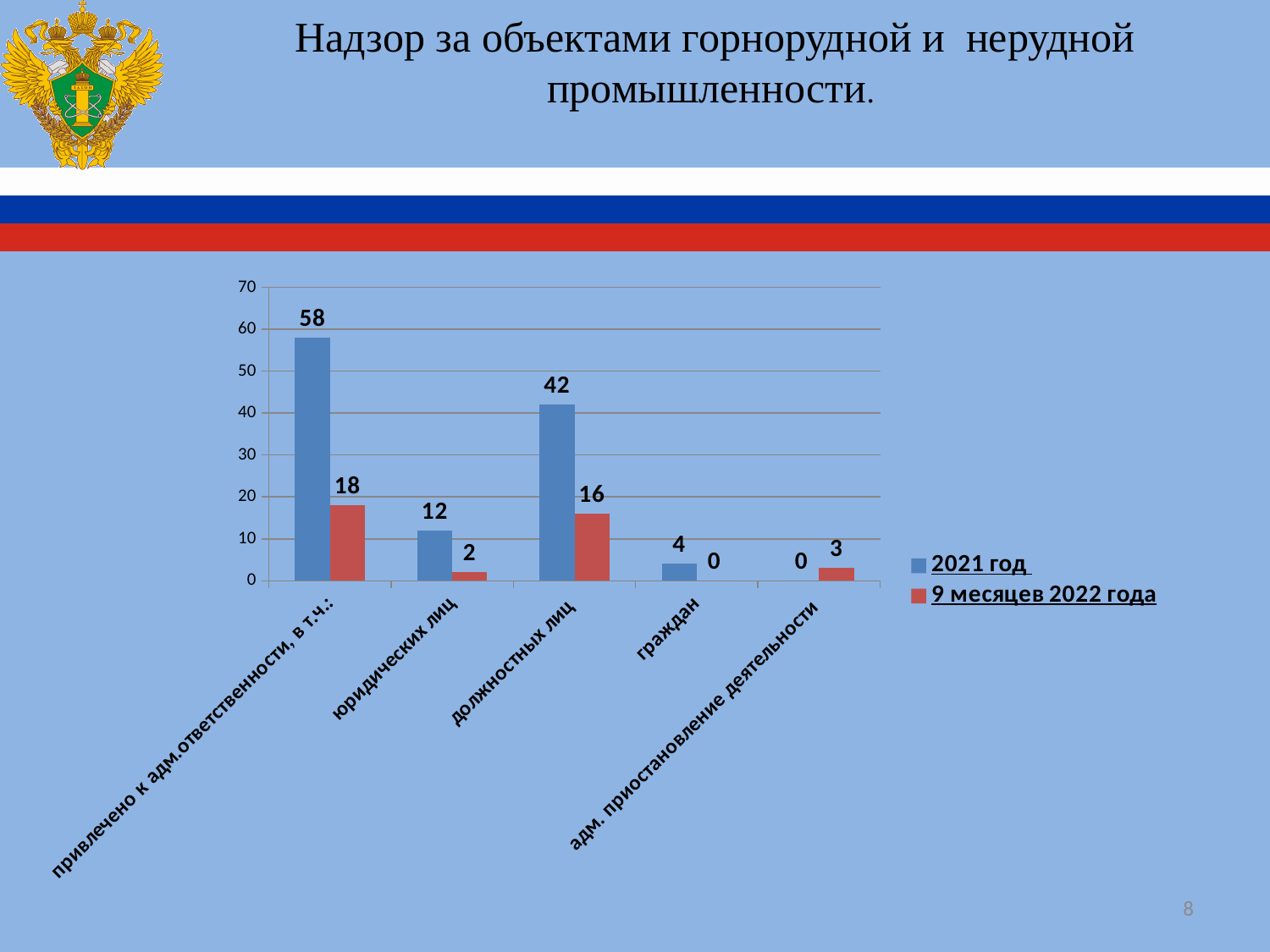
What is the value for "адм. приостановление деятельности" in the "9 месяцев 2022 года" series? 3 How many series does the legend list? 2 What colour are the bars for the "9 месяцев 2022 года" series? red What is the value for "юридических лиц" in the "2021 год" series? 12 What is the difference between the "2021 год" and "9 месяцев 2022 года" values for "привлечено к адм.ответственности, в т.ч.:"? 40 Which category has the lowest value in the "2021 год" series? адм. приостановление деятельности Which category has the highest value in the "2021 год" series? привлечено к адм.ответственности, в т.ч.: What kind of chart is shown on the slide? bar chart What is the value for "граждан" in the "2021 год" series? 4 How many categories are shown on the x axis? 5 Which is larger for "должностных лиц": the "2021 год" value or the "9 месяцев 2022 года" value? 2021 год What is the value for "должностных лиц" in the "9 месяцев 2022 года" series? 16